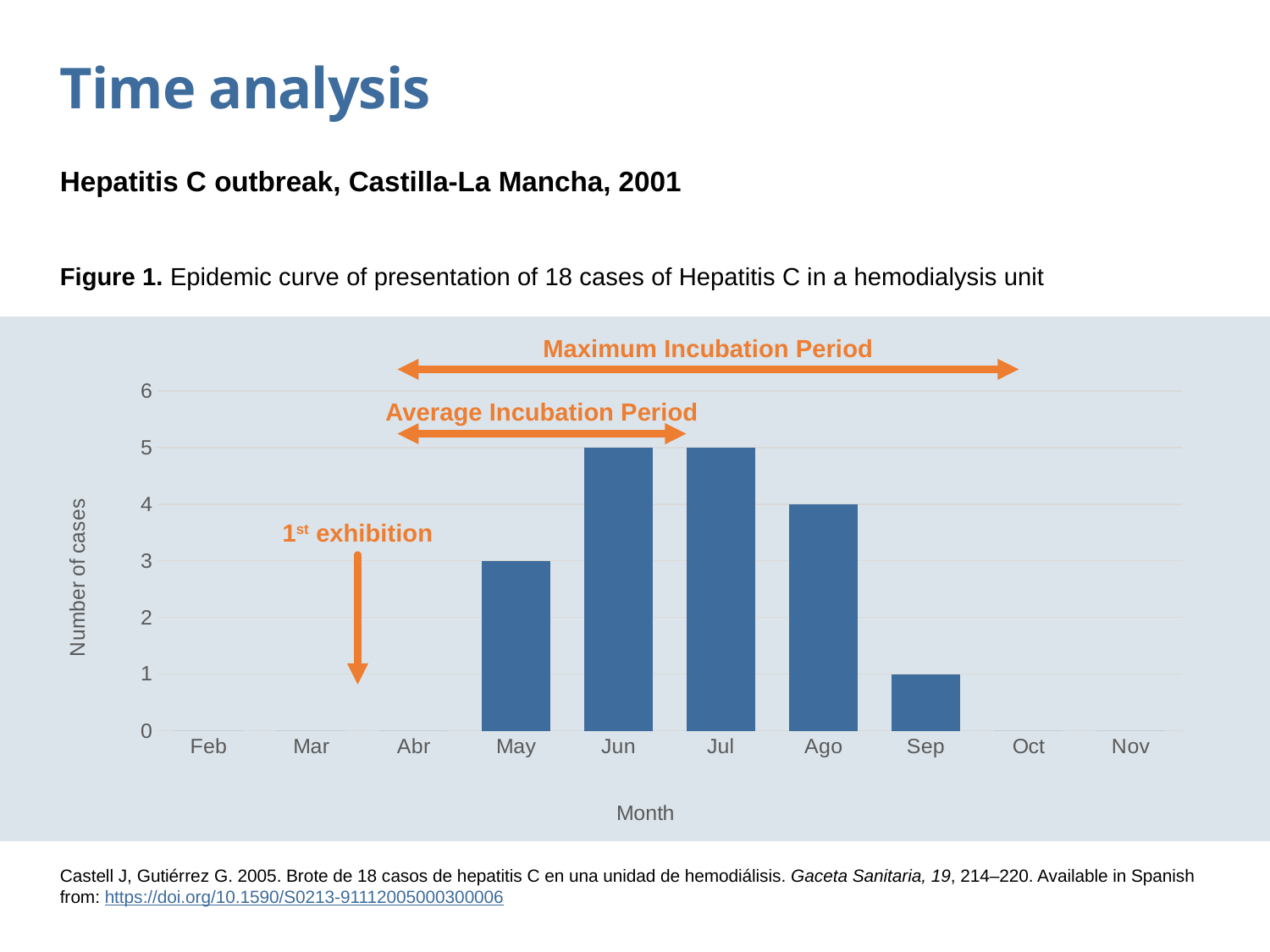
What is the difference in number of cases between Jul and Sep? 4 What is the number of cases for Sep? 1 Which month has more cases, Jun or Ago? Jun How many months are shown on the x axis? 10 What is the difference in number of cases between Ago and May? 1 What kind of chart is shown on the slide? Bar chart What is the number of cases for Jun? 5 What is the number of cases for May? 3 Do the number of cases rise or fall from Jul to Sep? Fall Which month has fewer cases, May or Sep? Sep What is the number of cases for Ago? 4 What is the label of the y axis? Number of cases